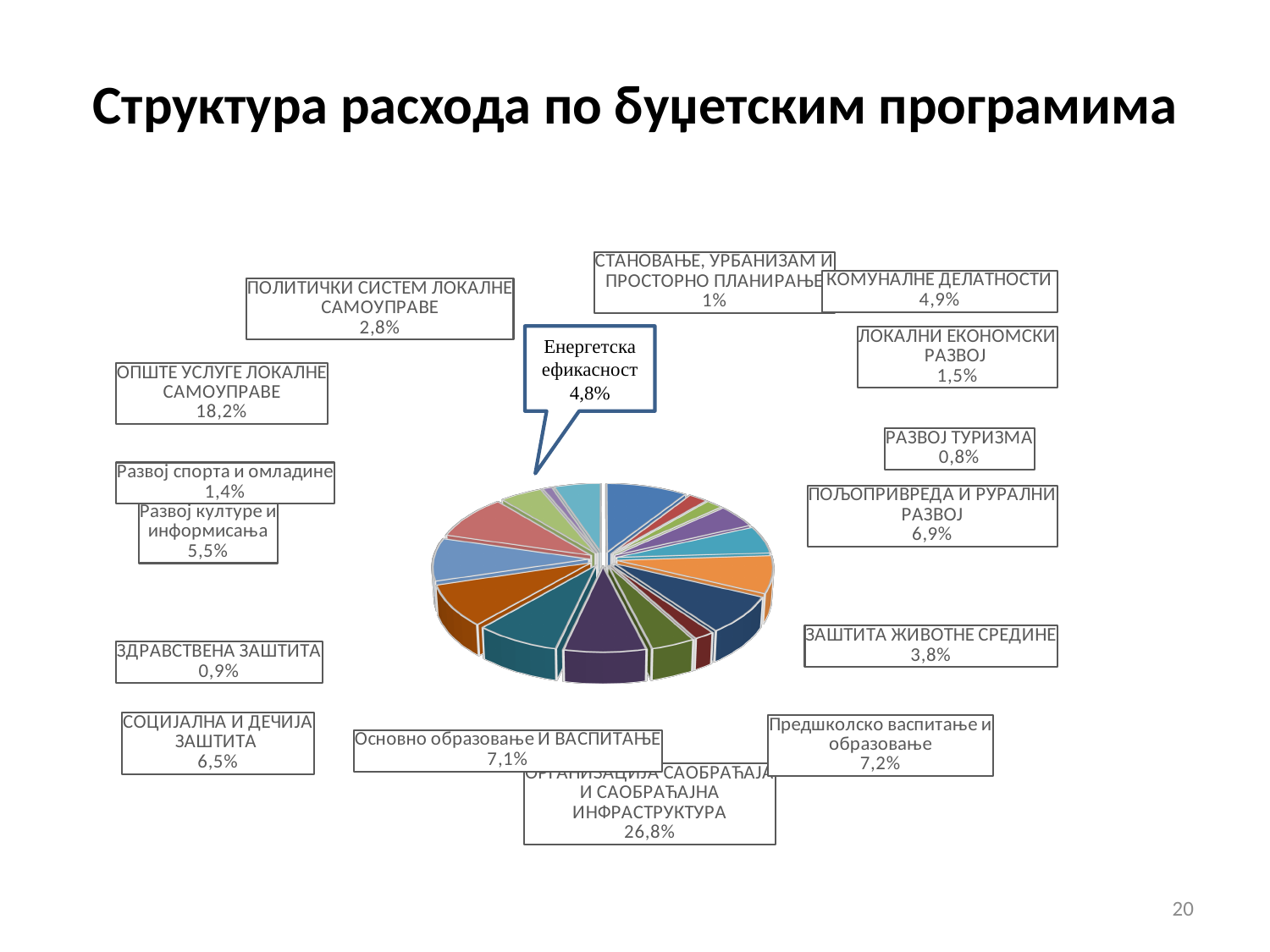
Which budget programme has the largest share of expenditure? ОРГАНИЗАЦИЈА САОБРАЋАЈА И САОБРАЋАЈНА ИНФРАСТРУКТУРА What is the title of the chart on the slide? Структура расхода по буџетским програмима What is the value for ПОЉОПРИВРЕДА И РУРАЛНИ РАЗВОЈ? 6,9% What share of expenditure goes to ОПШТЕ УСЛУГЕ ЛОКАЛНЕ САМОУПРАВЕ? 18,2% What share is shown for Предшколско васпитање и образовање? 7,2% Which has a larger share: Основно образовање И ВАСПИТАЊЕ or Предшколско васпитање и образовање? Предшколско васпитање и образовање What type of chart is shown on the slide? pie chart What percentage is shown for Енергетска ефикасност? 4,8% What is the difference between the shares of КОМУНАЛНЕ ДЕЛАТНОСТИ and ЗАШТИТА ЖИВОТНЕ СРЕДИНЕ? 1,1% What is the difference between the shares of ОПШТЕ УСЛУГЕ ЛОКАЛНЕ САМОУПРАВЕ and Предшколско васпитање и образовање? 11,0% Which budget programme has the smallest share of expenditure? РАЗВОЈ ТУРИЗМА How many budget programmes are labelled on the pie chart? 16